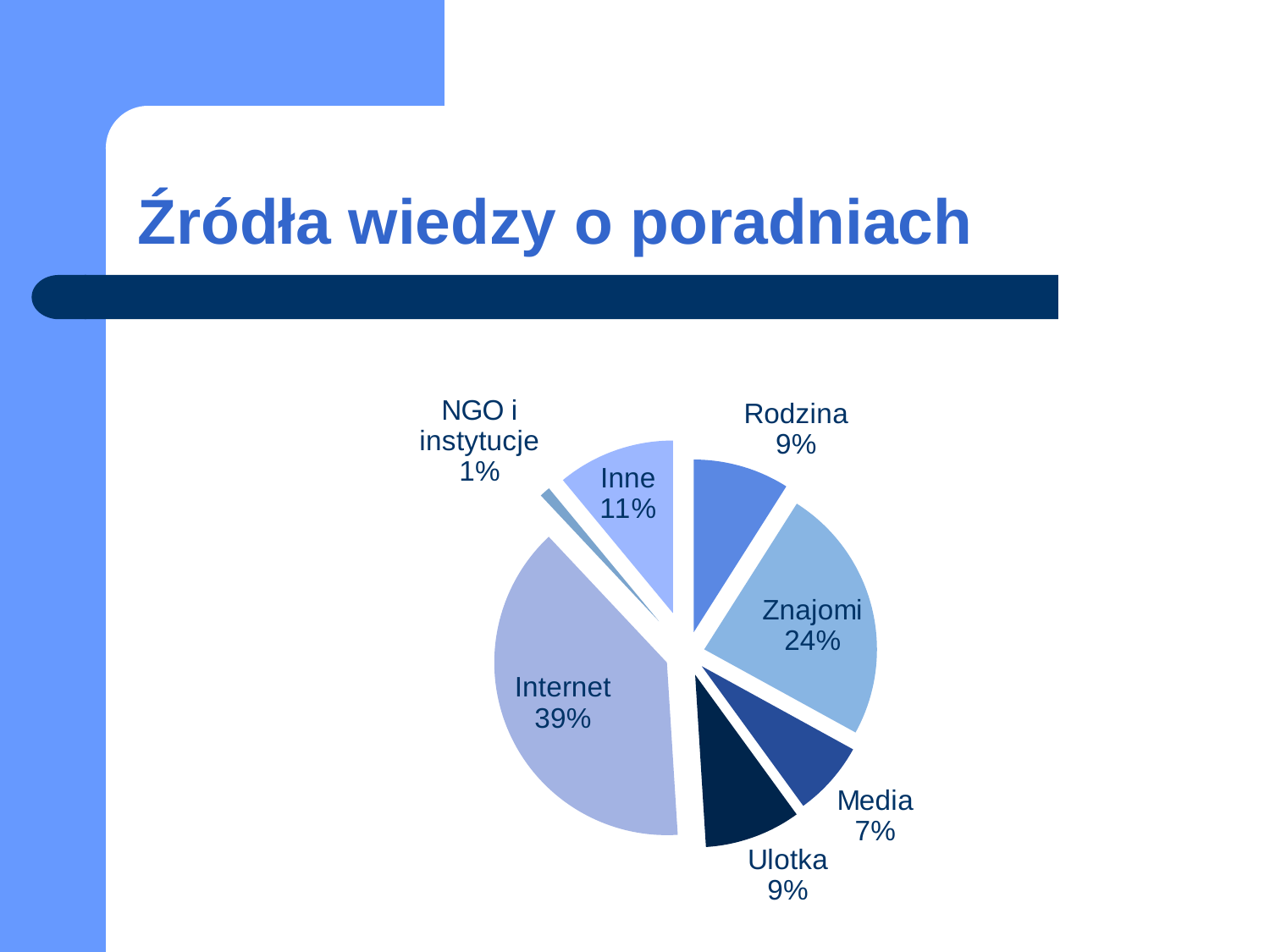
What is the value for Inne? 11% What is the value for Media? 7% What kind of chart is shown on the slide? pie chart What is the value for Znajomi? 24% Which category has the smallest slice? NGO i instytucje How many slices does the pie chart have? 7 What is the difference between the Internet and Znajomi shares? 15% Which is larger, Inne or Media? Inne What is the title of the slide? Źródła wiedzy o poradniach Which category has the largest slice? Internet What share of the pie does Internet have? 39% What is the difference between the Rodzina and Media shares? 2%